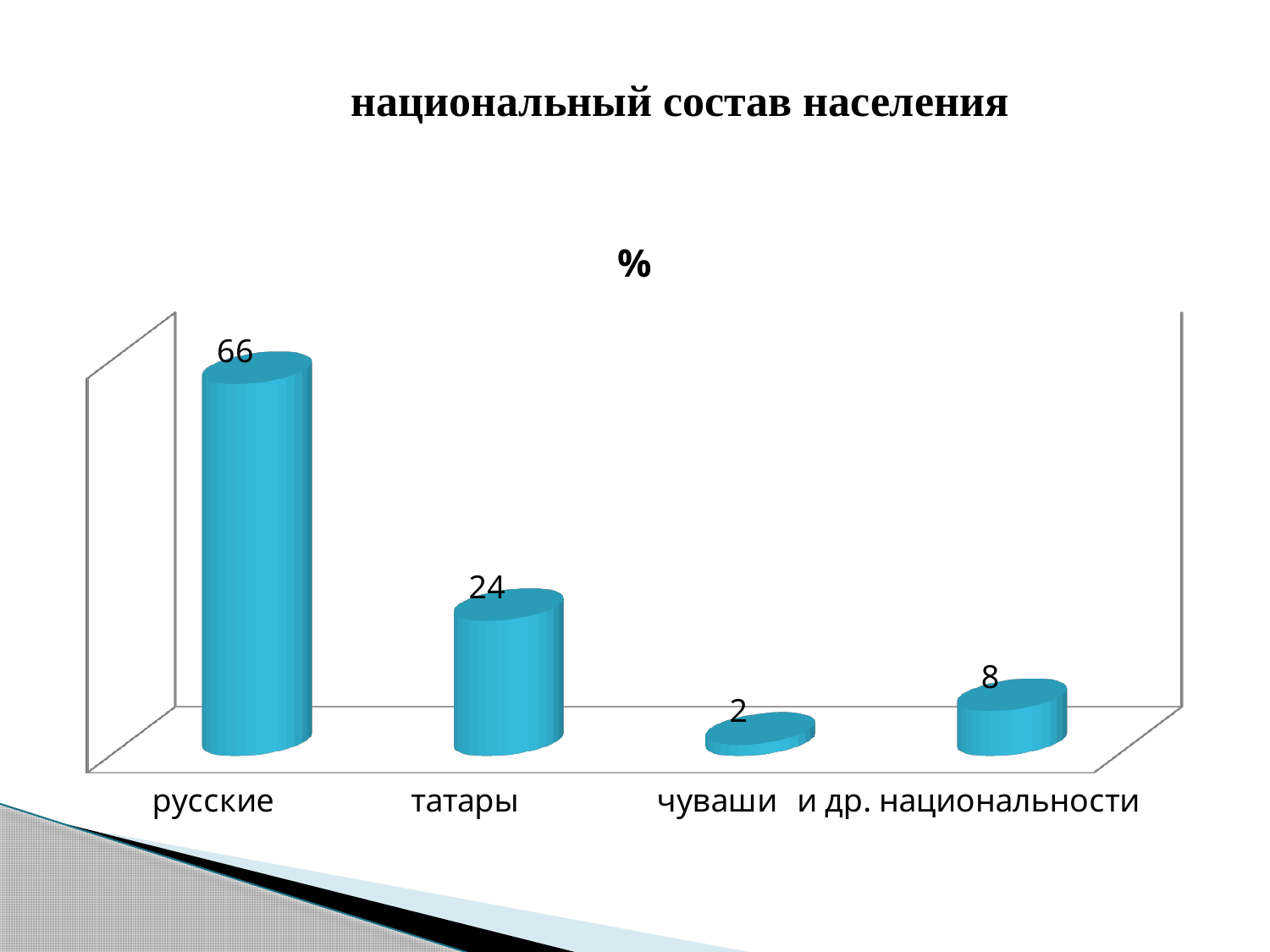
What is the value for чуваши? 2 What is the difference between the values for русские and татары? 42 What kind of chart is shown on the slide? bar chart Which category has the highest value? русские What is the value for русские? 66 How many categories are shown in the chart? 4 What is the value for татары? 24 Which is larger, the value for татары or the value for и др. национальности? татары What is the title of the chart? % What is the value for и др. национальности? 8 What is the difference between the values for и др. национальности and чуваши? 6 Which category has the lowest value? чуваши